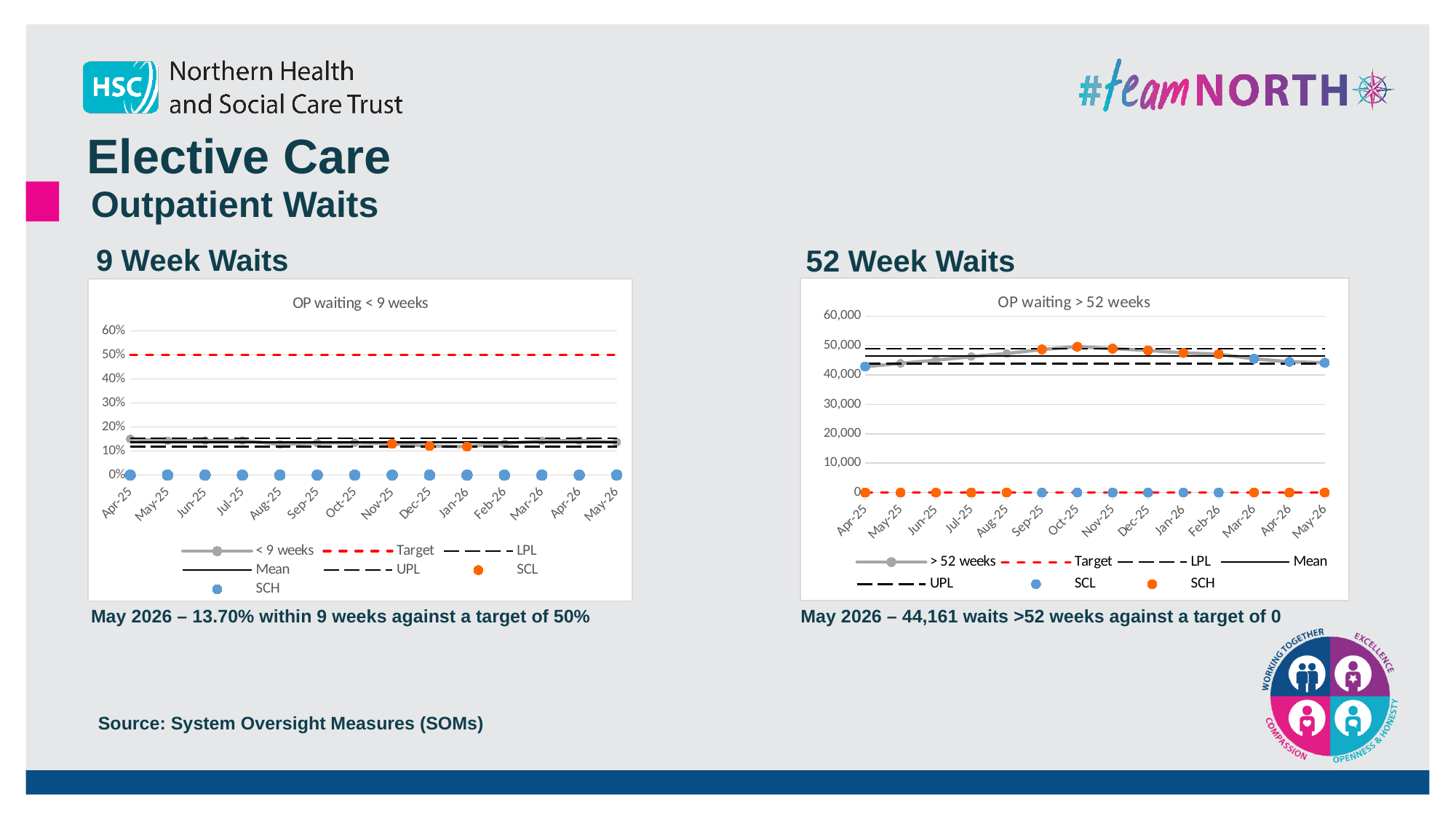
How many months are plotted along the x axis of the 'OP waiting > 52 weeks' chart? 14 According to the slide, what was the percentage of outpatients waiting within 9 weeks in May 2026? 13.70% In the 'OP waiting < 9 weeks' chart, is the Target line greater or less than 40%? greater In the 'OP waiting > 52 weeks' chart, do the > 52 weeks values rise or fall from Apr-25 to Oct-25? rise In the 'OP waiting > 52 weeks' chart, which month has the highest > 52 weeks value? Oct-25 In the 'OP waiting > 52 weeks' chart, which is larger, the > 52 weeks value for Oct-25 or for Apr-25? Oct-25 What is the title of the chart on the left of the slide? OP waiting < 9 weeks According to the slide, how many outpatient waits were over 52 weeks in May 2026? 44,161 In the 'OP waiting > 52 weeks' chart, is the > 52 weeks value for Oct-25 greater or less than 40,000? greater What kind of chart is the 'OP waiting < 9 weeks' chart? line chart How many series does the legend of the 'OP waiting < 9 weeks' chart list? 7 In the 'OP waiting < 9 weeks' chart, is the < 9 weeks value for Apr-25 greater or less than 20%? less